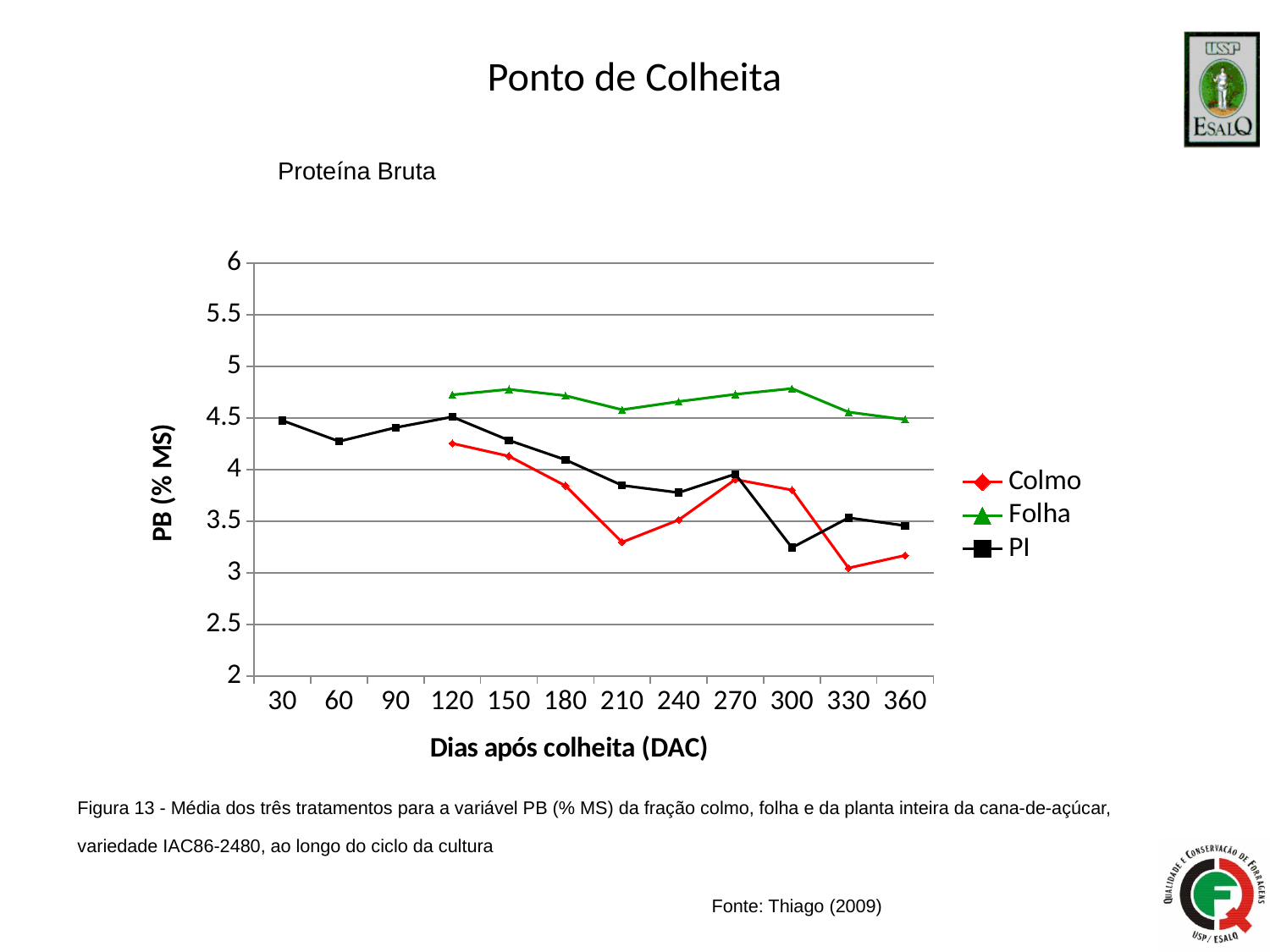
How many DAC categories are shown on the x axis? 12 What kind of chart is shown on the slide? line chart Is the value for PI at 30 DAC greater or less than 4? greater At which DAC does the PI series reach its lowest value? 300 Is the value for PI at 300 DAC greater or less than 3.5? less Does the Colmo series overall rise or fall from 120 DAC to 360 DAC? fall At 300 DAC, which series has the higher value, Colmo or PI? Colmo At 120 DAC, which series has the higher value, Folha or Colmo? Folha How many series does the legend list? 3 Is the value for Folha at 360 DAC greater or less than 4? greater Which series has the highest value at 360 DAC? Folha